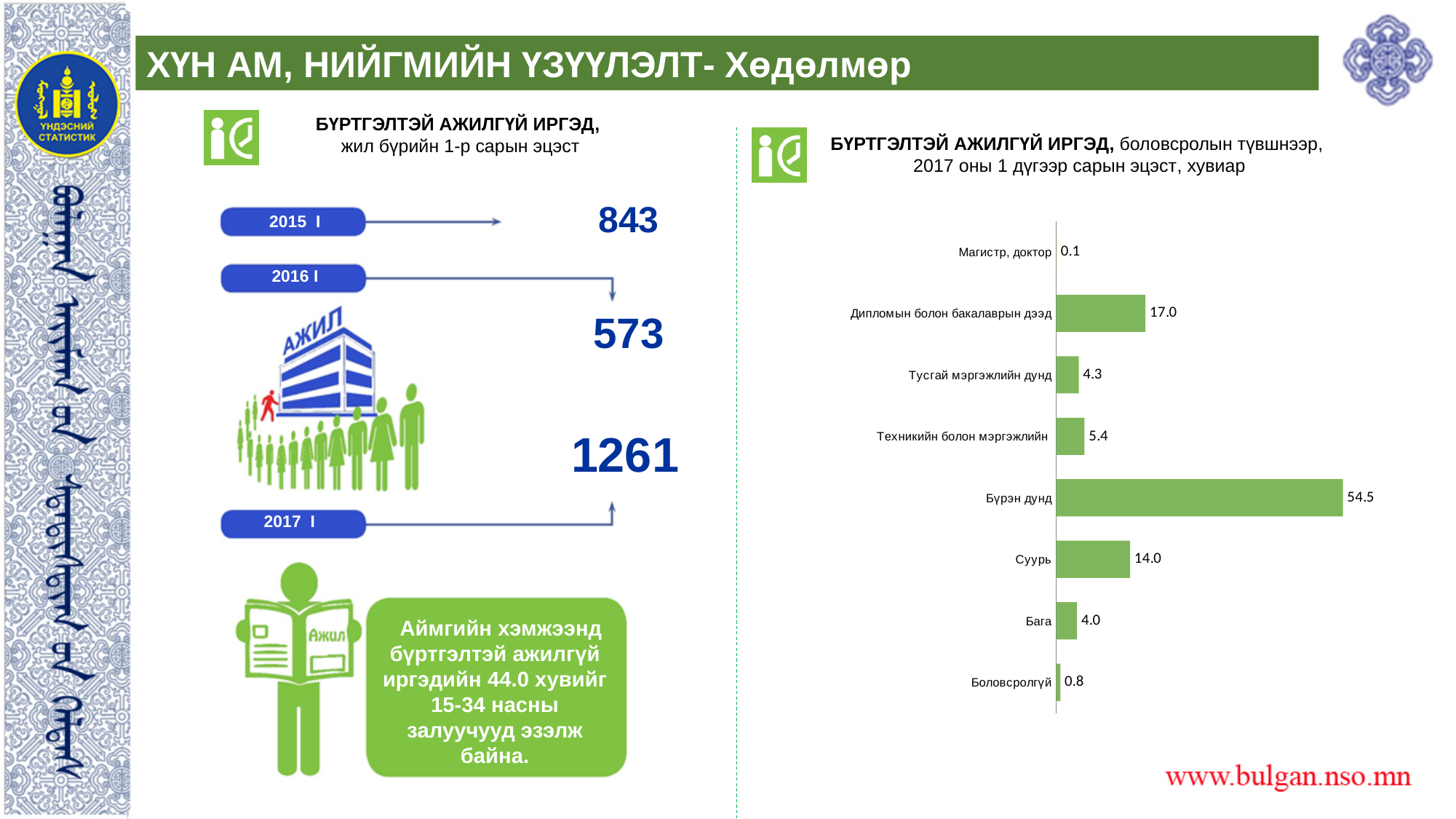
How many categories are shown in the bar chart on the right? 8 What kind of chart is shown on the right side of the slide? Bar chart In the bar chart on the right, which category has the highest value? Бүрэн дунд In the bar chart on the right, which is larger: the value for Суурь or the value for Бага? Суурь In the bar chart on the right, what is the difference between the values for Бүрэн дунд and Дипломын болон бакалаврын дээд? 37.5 In the bar chart on the right, what is the value for Боловсролгүй? 0.8 In the bar chart on the right, which category has the lowest value? Магистр, доктор In the bar chart on the right, what is the value for Дипломын болон бакалаврын дээд? 17.0 In the bar chart on the right, what is the value for Суурь? 14.0 In the bar chart on the right, what is the difference between the values for Техникийн болон мэргэжлийн and Тусгай мэргэжлийн дунд? 1.1 What colour are the bars in the chart on the right? Green In the bar chart on the right, what is the value for Бүрэн дунд? 54.5